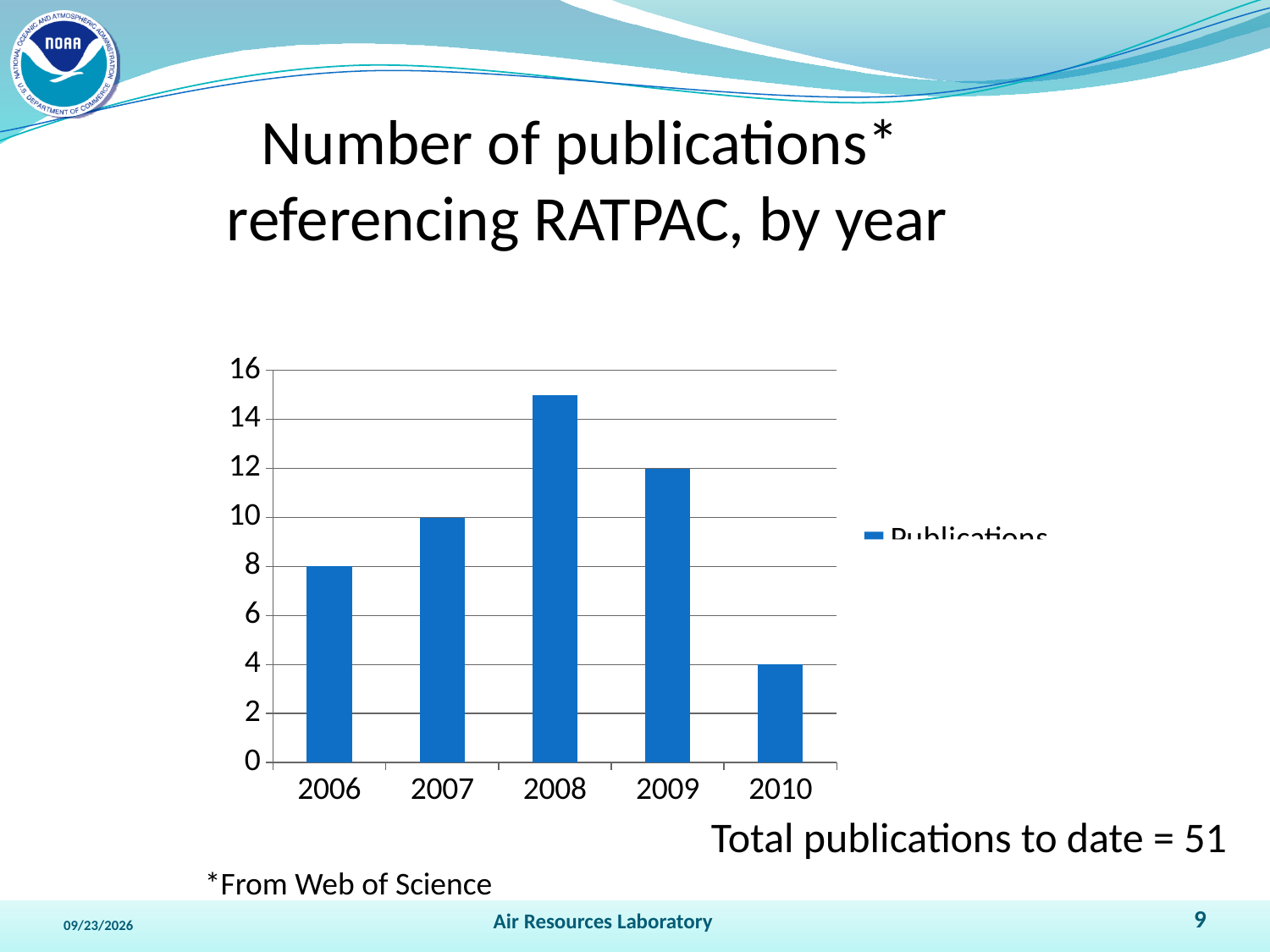
What is the number of publications for 2010? 4 What is the number of publications for 2007? 10 How many years are shown on the x axis of the chart? 5 Which year has more publications, 2007 or 2009? 2009 What type of chart is shown on the slide? bar chart What is the difference between the number of publications in 2009 and in 2006? 4 What is the title of the chart on the slide? Number of publications* referencing RATPAC, by year What is the number of publications for 2006? 8 What is the number of publications for 2009? 12 Which year has the highest number of publications? 2008 Which year has the lowest number of publications? 2010 Is the value for 2008 greater or less than 14? greater